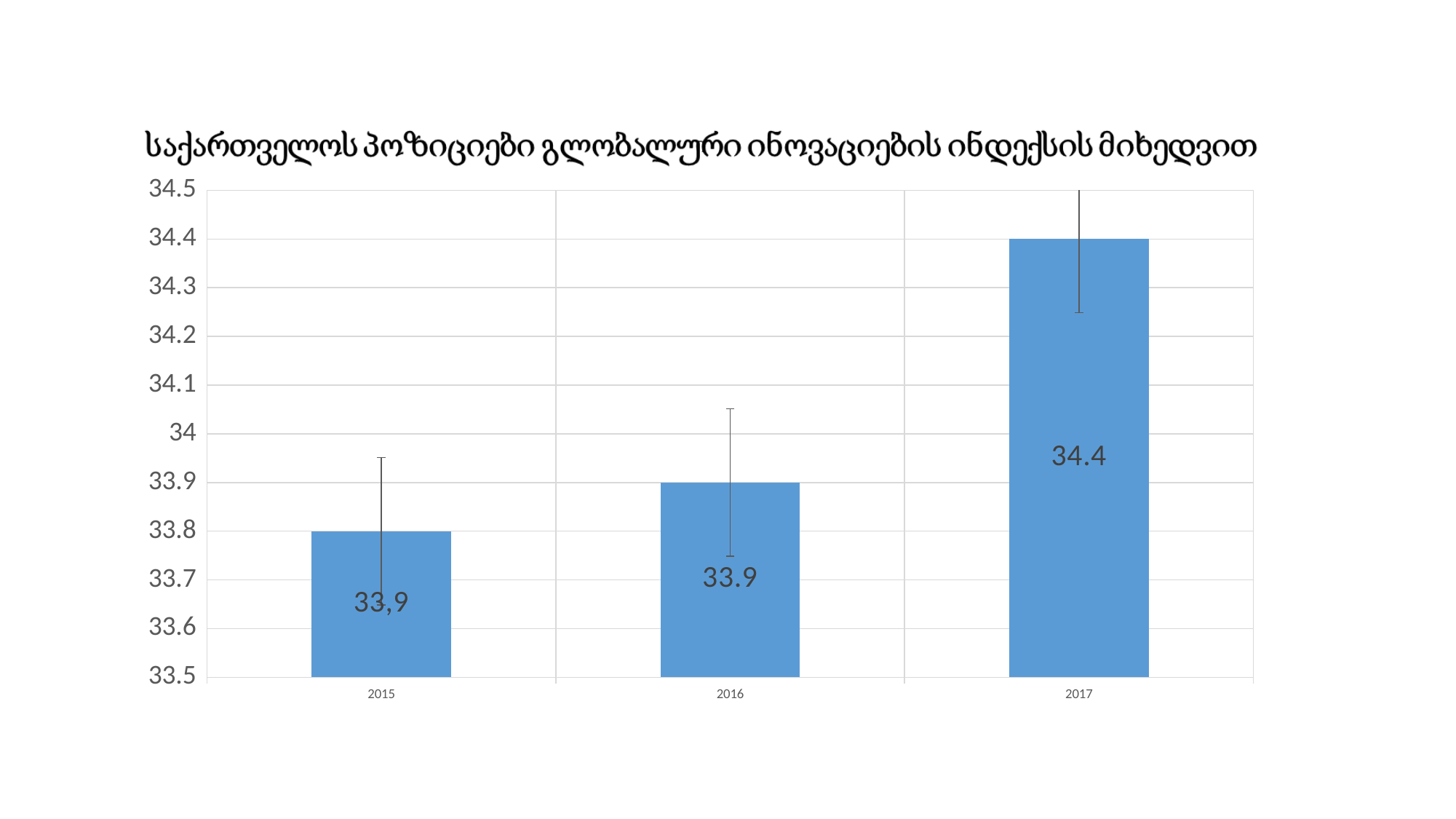
What is the value shown for 2017? 34.4 What is the value shown for 2016? 33.9 Which year has the highest value? 2017 Is the value for 2015 greater or less than 34? less Which is larger, the value for 2016 or the value for 2017? 2017 How many years are shown on the x axis of the chart? 3 What colour are the bars in the chart? blue What is the difference between the values for 2017 and 2016? 0.5 Do the values rise or fall from 2015 to 2017? rise What is the lowest value shown on the vertical axis? 33.5 Is the value for 2017 greater or less than 34? greater What kind of chart is shown on the slide? bar chart